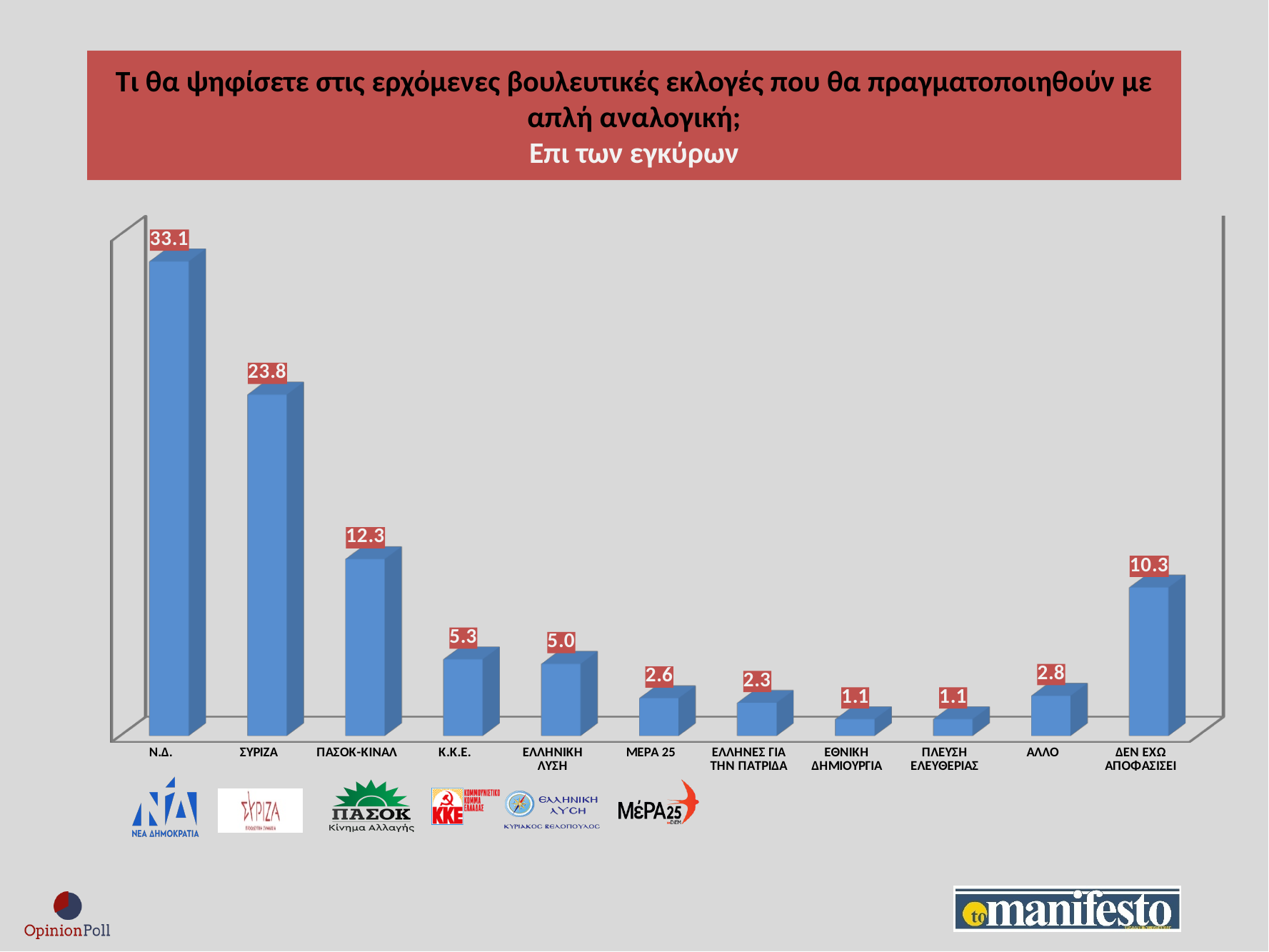
What is the value for ΕΛΛΗΝΙΚΗ ΛΥΣΗ? 5.0 What is the difference between the values for Ν.Δ. and ΣΥΡΙΖΑ? 9.3 Which category has the highest value? Ν.Δ. How many categories are shown on the chart? 11 What is the value for ΣΥΡΙΖΑ? 23.8 What is the difference between the values for ΠΑΣΟΚ-ΚΙΝΑΛ and ΔΕΝ ΕΧΩ ΑΠΟΦΑΣΙΣΕΙ? 2.0 What kind of chart is shown on the slide? Bar chart What is the value for Ν.Δ.? 33.1 What is the value for ΑΛΛΟ? 2.8 Which is larger, the value for ΜΕΡΑ 25 or the value for ΑΛΛΟ? ΑΛΛΟ What is the value for ΔΕΝ ΕΧΩ ΑΠΟΦΑΣΙΣΕΙ? 10.3 Which is larger, the value for Κ.Κ.Ε. or the value for ΠΑΣΟΚ-ΚΙΝΑΛ? ΠΑΣΟΚ-ΚΙΝΑΛ